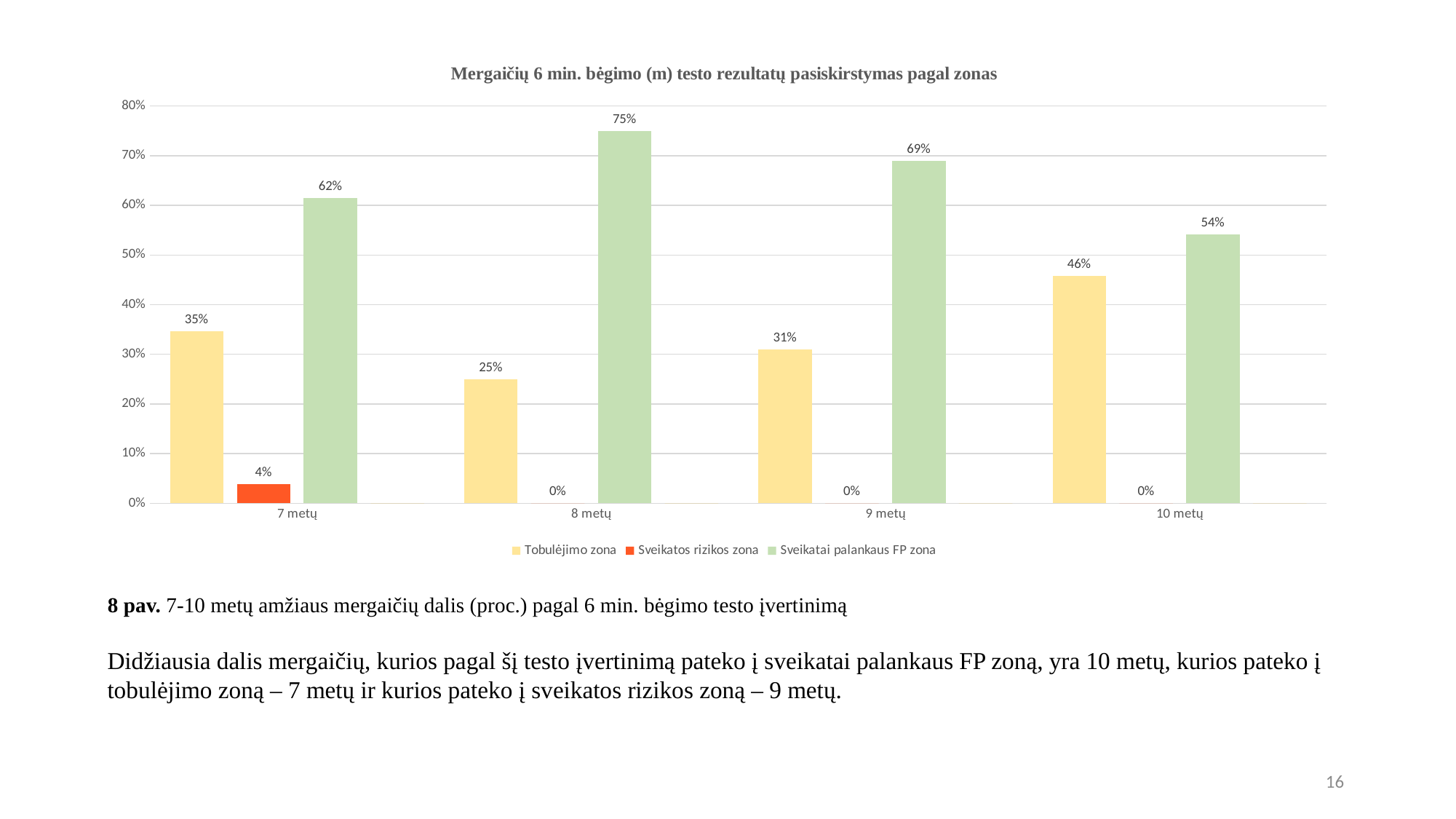
Which is larger: Tobulėjimo zona at 9 metų or Tobulėjimo zona at 10 metų? Tobulėjimo zona at 10 metų What is the value for Tobulėjimo zona at 10 metų? 46% What is the value for Sveikatai palankaus FP zona at 8 metų? 75% Which age group has the lowest value for Tobulėjimo zona? 8 metų What is the value for Sveikatos rizikos zona at 7 metų? 4% What is the title of the chart? Mergaičių 6 min. bėgimo (m) testo rezultatų pasiskirstymas pagal zonas What is the value for Tobulėjimo zona at 7 metų? 35% How many age groups are shown on the x axis? 4 How many series does the legend list? 3 What is the difference between the Sveikatai palankaus FP zona values at 9 metų and 10 metų? 15% What kind of chart is shown on the slide? Bar chart Which age group has the highest value for Sveikatai palankaus FP zona? 8 metų